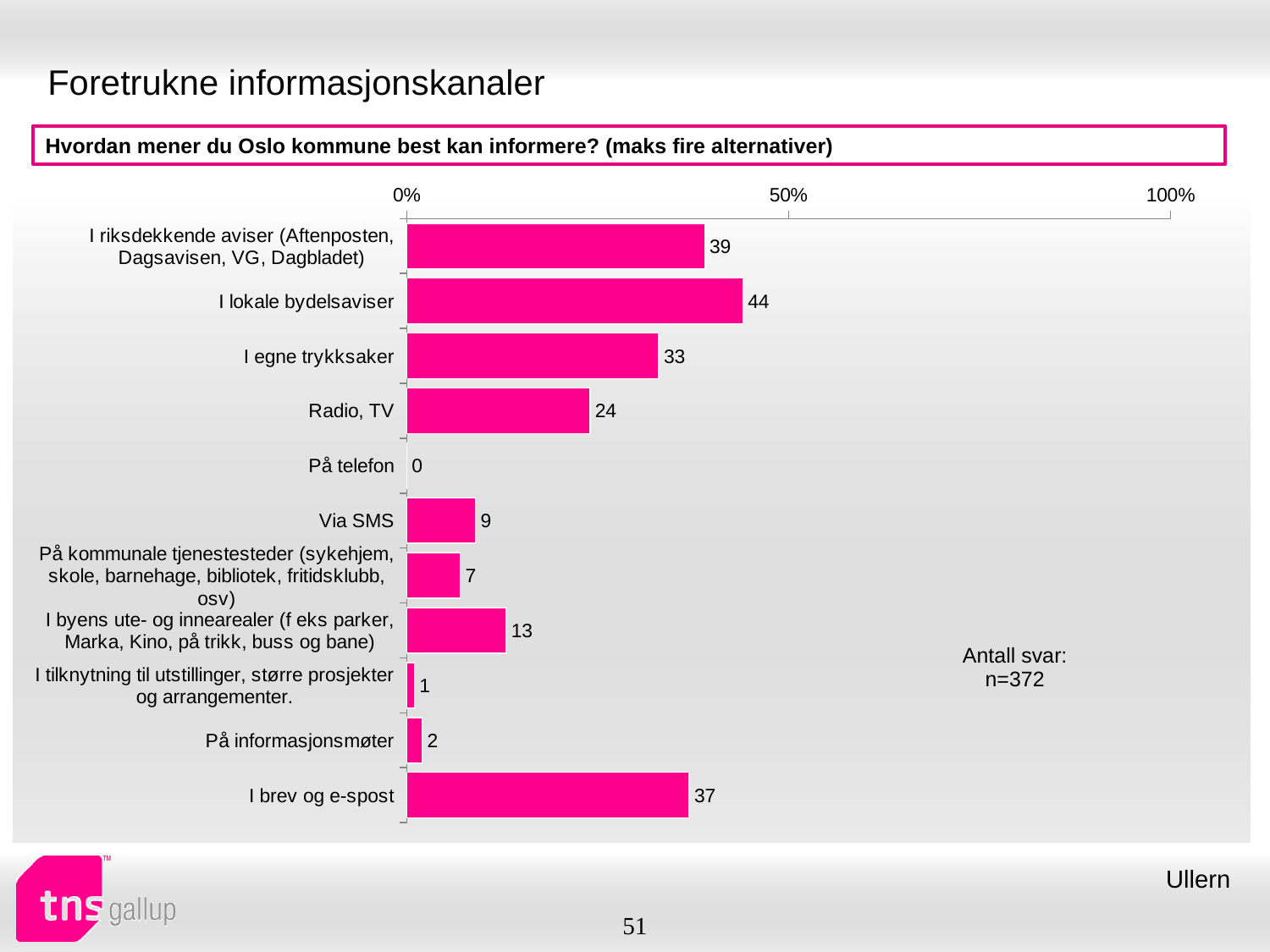
What is the value for 'Via SMS'? 9 What kind of chart is shown on the slide? bar chart What is the number of respondents (n) stated on the slide? n=372 Is the value for 'I lokale bydelsaviser' greater or less than 50%? less Which is larger: the value for 'I riksdekkende aviser (Aftenposten, Dagsavisen, VG, Dagbladet)' or the value for 'I brev og e-spost'? I riksdekkende aviser (Aftenposten, Dagsavisen, VG, Dagbladet) Which category has the lowest value? På telefon How many categories are shown in the chart? 11 What is the difference between the values for 'I lokale bydelsaviser' and 'I egne trykksaker'? 11 What is the value for 'I brev og e-spost'? 37 What is the value for 'I lokale bydelsaviser'? 44 Which category has the highest value? I lokale bydelsaviser What is the value for 'Radio, TV'? 24